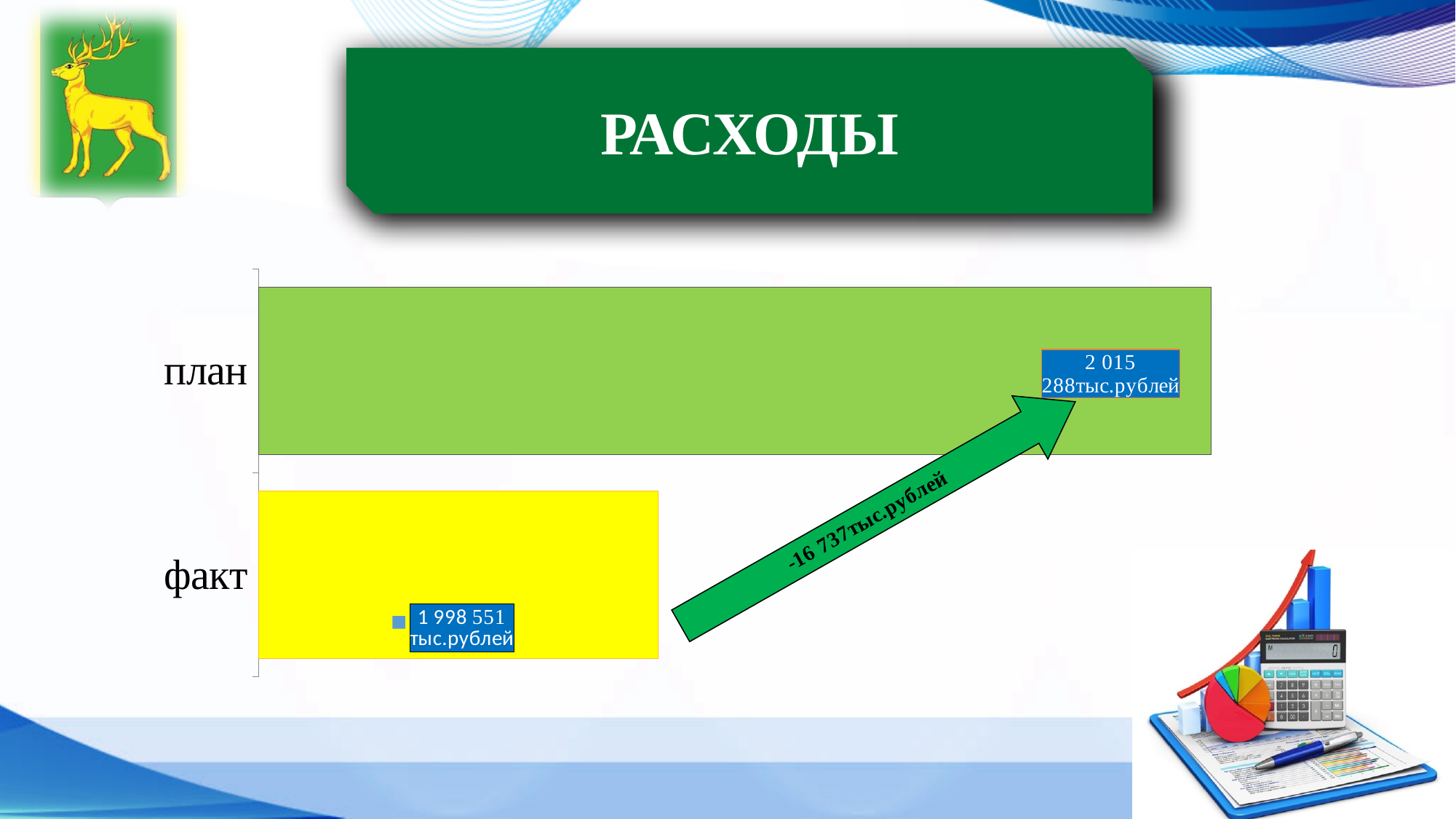
What is the difference between the план and факт values? 16 737 тыс.рублей Which category has the highest value? план Which category has the higher value, план or факт? план What value is written on the green arrow between the bars? -16 737тыс.рублей What is the value shown for факт? 1 998 551 тыс.рублей What is the title of the slide above the chart? РАСХОДЫ What colour is the bar for факт? yellow What kind of chart is shown on the slide? bar chart How many categories are shown in the chart? 2 Which category has the lowest value? факт What is the value shown for план? 2 015 288 тыс.рублей